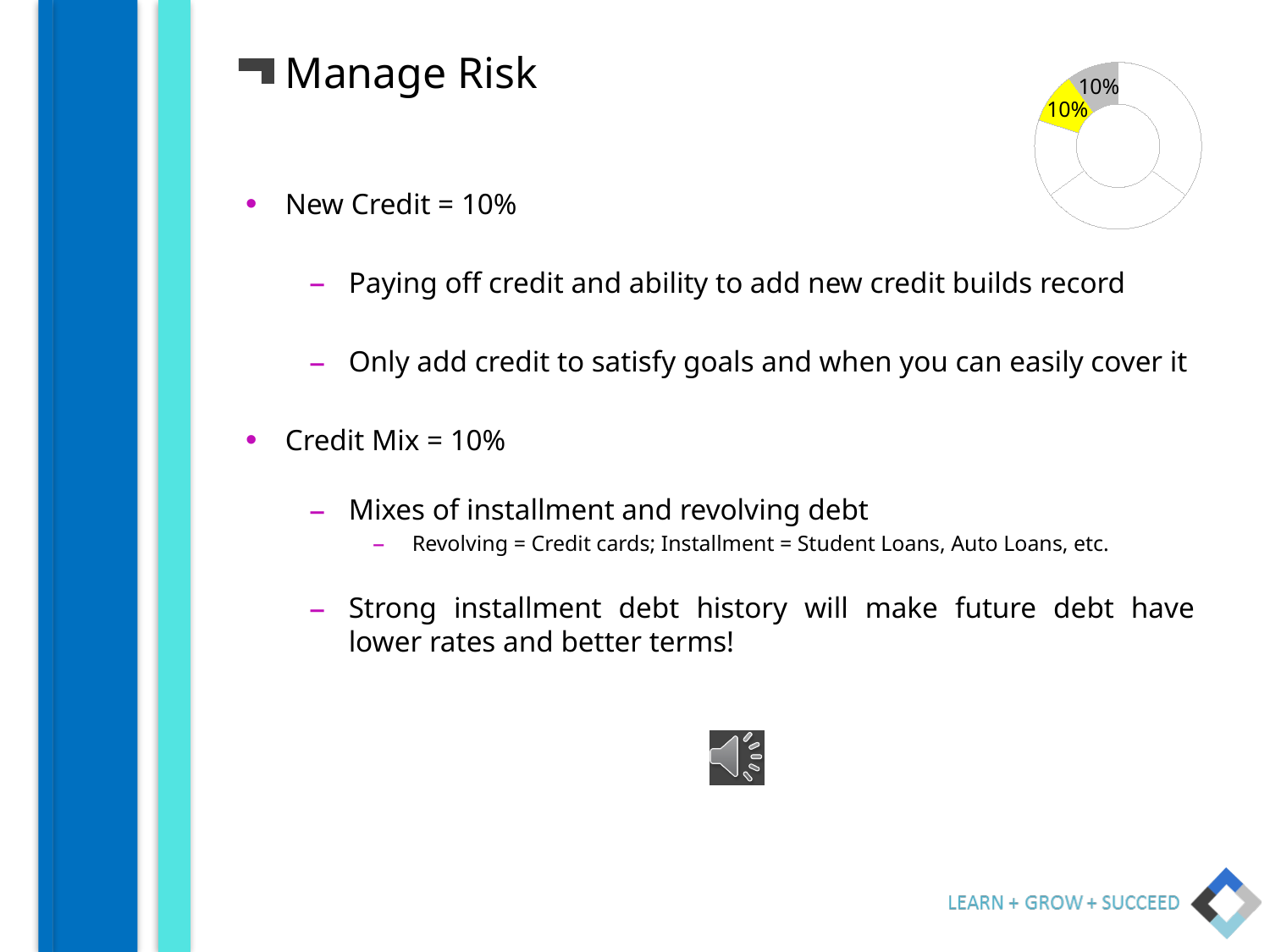
Do the yellow and gray slices of the doughnut chart show the same value? Yes What is the difference between the values of the yellow and gray slices? 0% What value is printed on the yellow slice of the doughnut chart? 10% How many slices does the doughnut chart have in total? 5 How many slices of the doughnut chart have a data label printed on them? 2 Does the doughnut chart include a legend? No What share of the doughnut does the gray slice represent? 10% What value is printed on the gray slice of the doughnut chart? 10% What share of the doughnut does the yellow slice represent? 10% What kind of chart is shown in the top-right corner of the slide? Doughnut chart